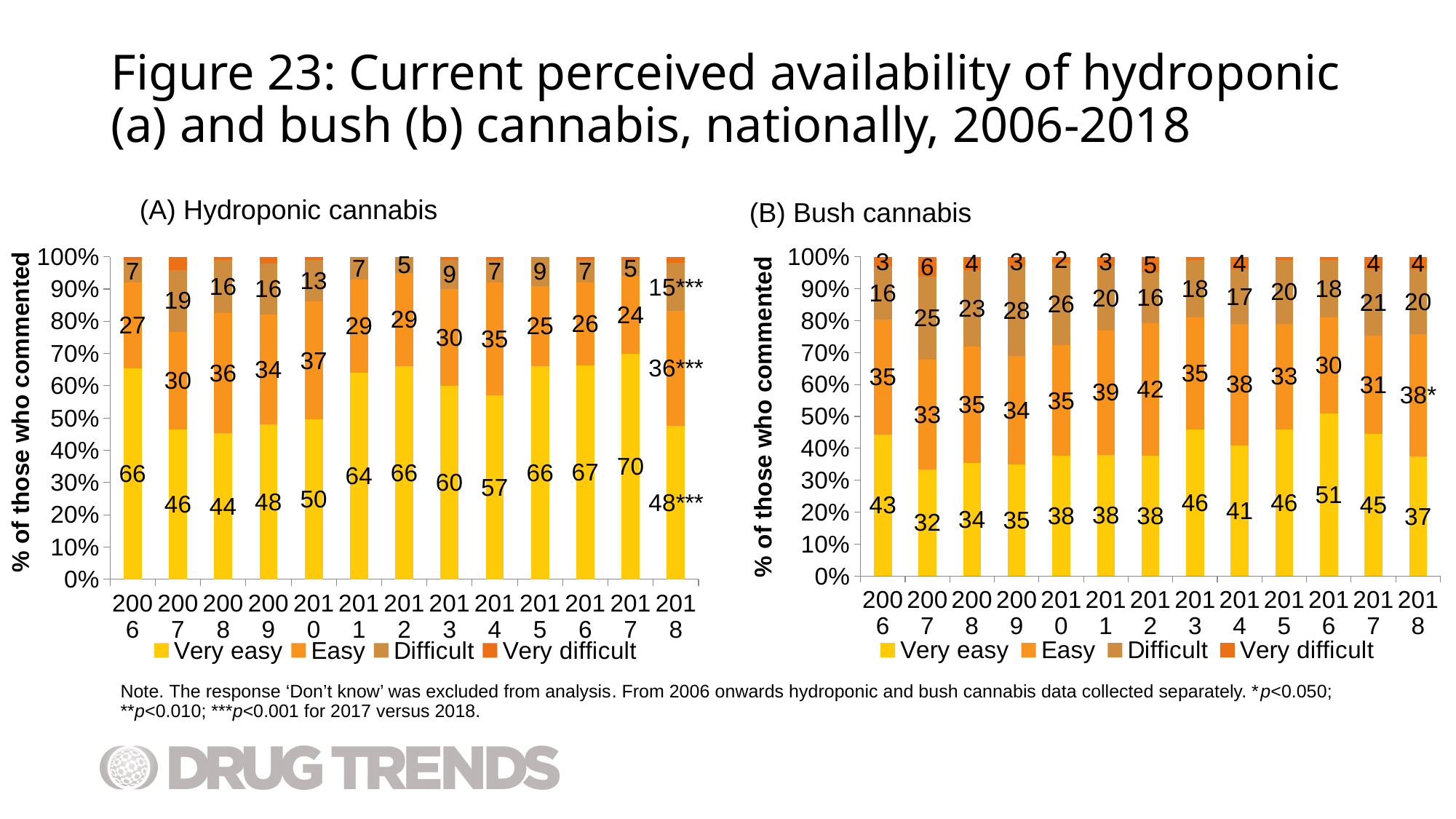
In chart (A) Hydroponic cannabis, what percentage reported 'Very easy' in 2017? 70 In chart (A) Hydroponic cannabis, by how many percentage points did the 'Very easy' value fall from 2017 to 2018? 22 In chart (A) Hydroponic cannabis, which year has the highest 'Very easy' percentage? 2017 In chart (B) Bush cannabis, which year has the larger 'Easy' value, 2011 or 2012? 2012 What kind of chart is chart (A) Hydroponic cannabis? Stacked bar chart In chart (B) Bush cannabis, what percentage reported 'Difficult' in 2009? 28 In chart (B) Bush cannabis, which year has the lowest 'Very easy' percentage? 2007 How many series does the legend of chart (A) Hydroponic cannabis list? 4 What is the y-axis label of chart (B) Bush cannabis? % of those who commented How many years are shown on the x axis of chart (B) Bush cannabis? 13 In chart (A) Hydroponic cannabis, what percentage reported 'Easy' in 2010? 37 In chart (B) Bush cannabis, what percentage reported 'Very easy' in 2016? 51